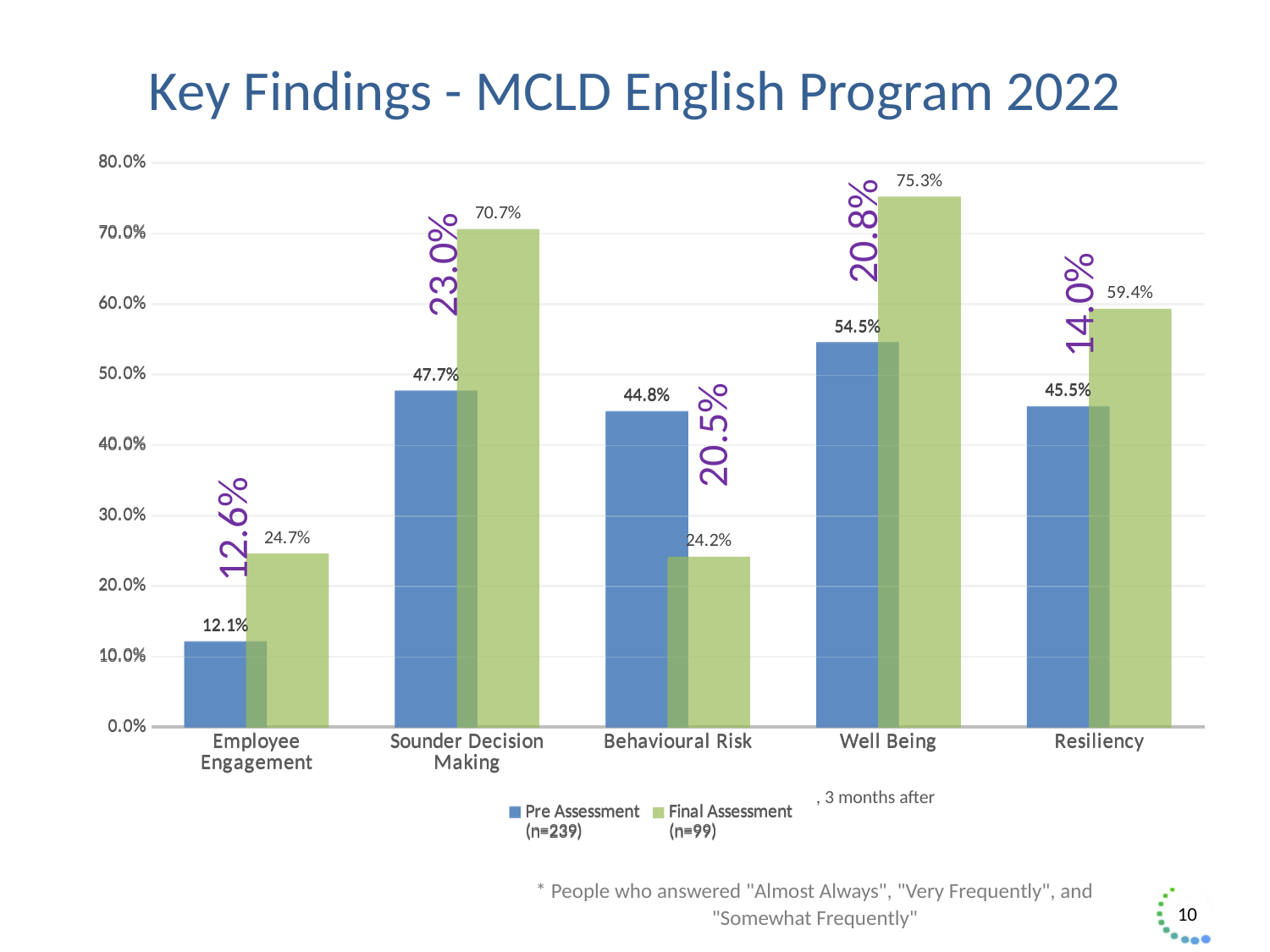
What is the Final Assessment value for Sounder Decision Making? 70.7% What is the Final Assessment value for Behavioural Risk? 24.2% Which category has the lowest Pre Assessment value? Employee Engagement What is the Pre Assessment value for Employee Engagement? 12.1% What kind of chart is shown on the slide? Bar chart Which category has the highest Final Assessment value? Well Being How many categories are shown on the x axis? 5 For Behavioural Risk, which is larger: the Pre Assessment value or the Final Assessment value? Pre Assessment What is the difference between the Final Assessment and Pre Assessment values for Sounder Decision Making? 23.0% What is the difference between the Final Assessment and Pre Assessment values for Well Being? 20.8% How many series does the legend list? 2 What is the Pre Assessment value for Resiliency? 45.5%